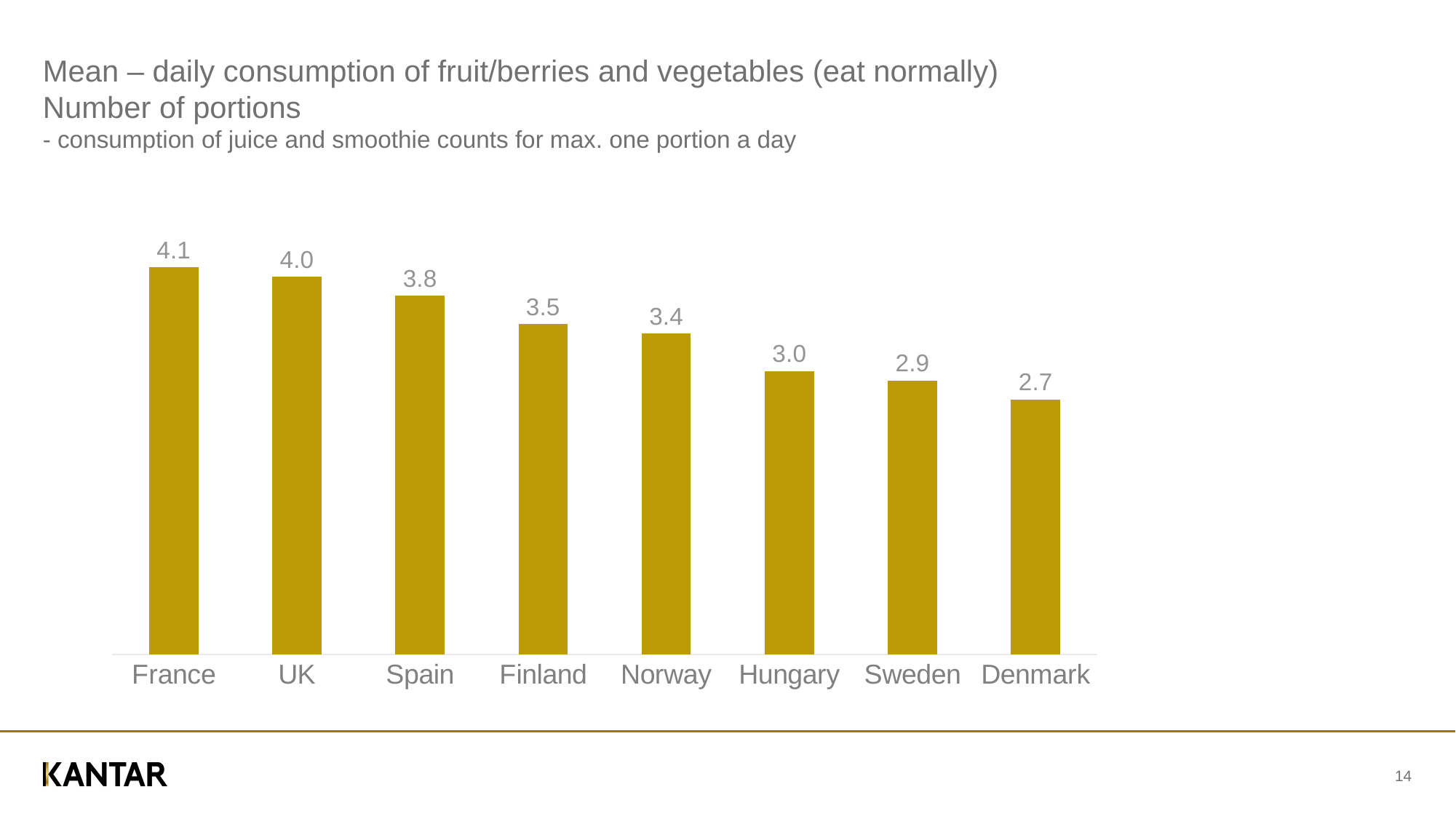
What is the mean number of daily portions for Norway? 3.4 What is the mean number of daily portions for Sweden? 2.9 What kind of chart is shown on the slide? Bar chart What is the difference between the values for Spain and Hungary? 0.8 What is the difference between the values for France and Denmark? 1.4 What colour are the bars in the chart? Gold Do the values rise or fall from left to right across the countries? Fall What is the mean number of daily portions for France? 4.1 How many countries are shown in the chart? 8 Which country has the highest mean number of daily portions? France Which has a higher value, Finland or Hungary? Finland Which country has the lowest mean number of daily portions? Denmark